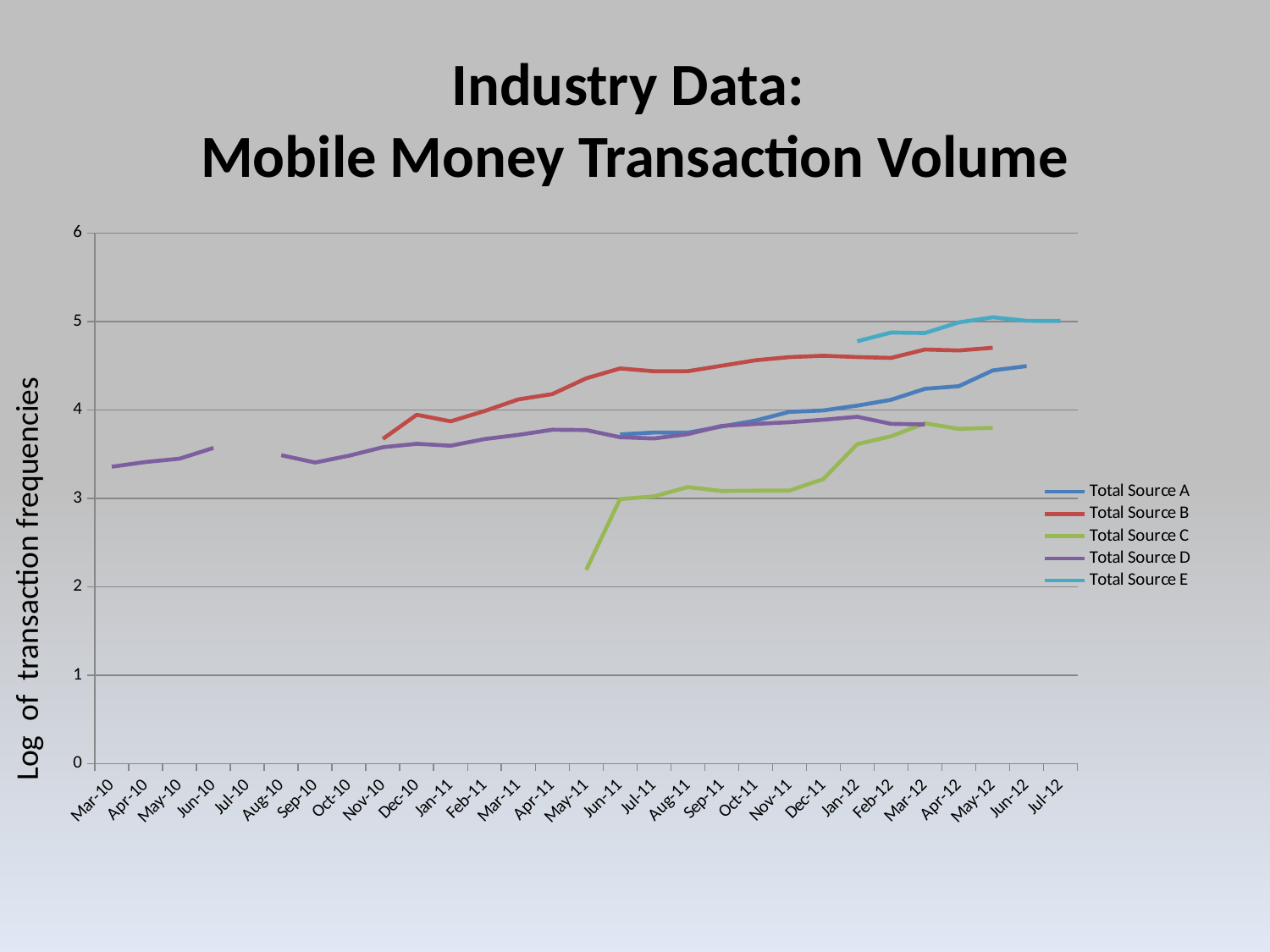
Does Total Source B generally rise or fall from Nov-10 to May-12? rise Is the value for Total Source B at Jun-11 greater or less than 4? greater What is the label on the y axis? Log of transaction frequencies Is the value for Total Source C at May-11 greater or less than 3? less Which series has the lowest plotted point on the chart? Total Source C Is the value for Total Source A at Jun-12 greater or less than 5? less How many series does the legend list? 5 Which series reaches the highest value on the chart? Total Source E How many months are labelled along the x axis? 29 What kind of chart is shown on the slide? line chart